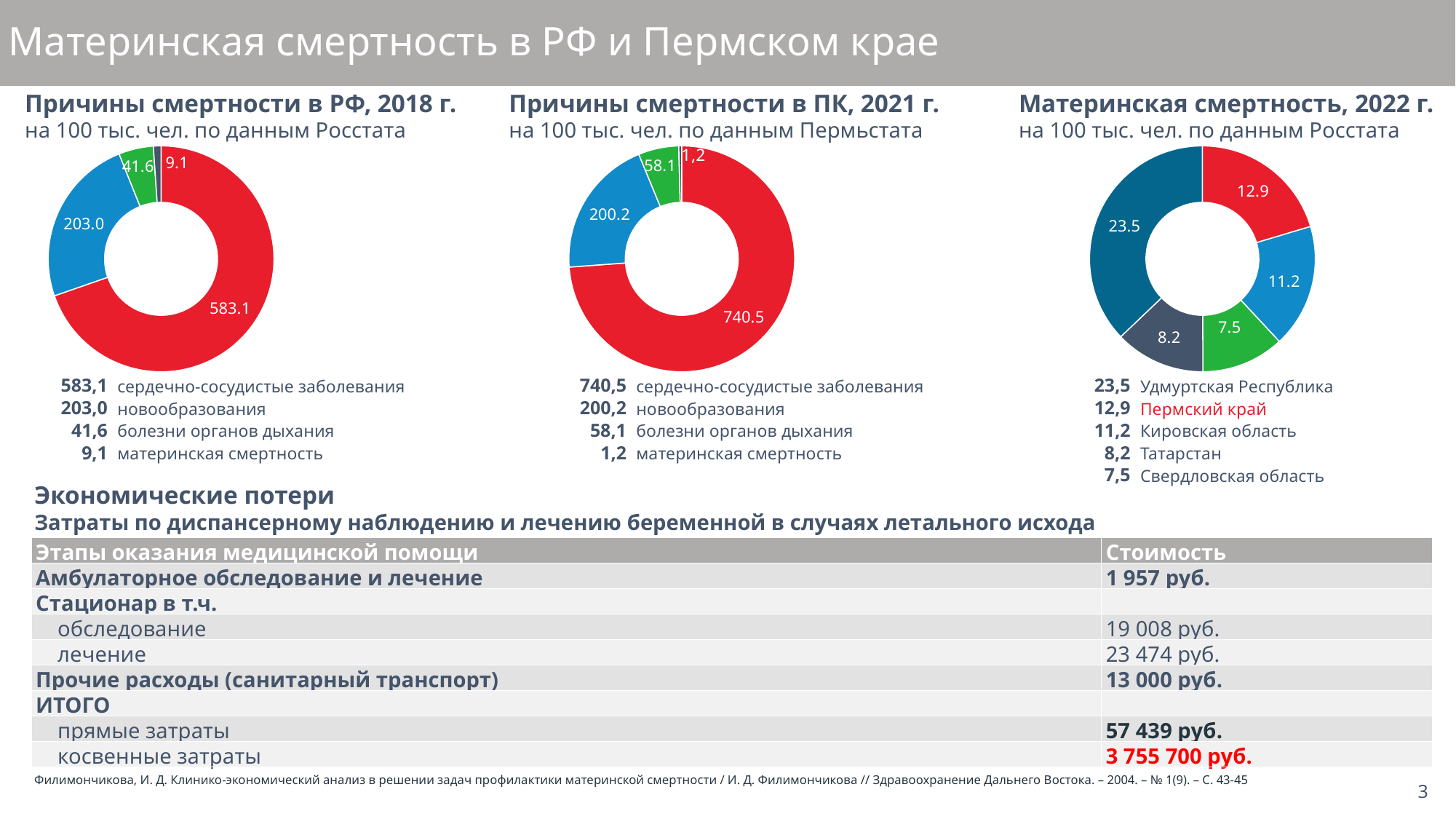
In the chart 'Причины смертности в РФ, 2018 г.', which is larger: новообразования or болезни органов дыхания? новообразования In the chart 'Материнская смертность, 2022 г.', what is the difference between Удмуртская Республика and Пермский край? 10.6 In the chart 'Причины смертности в ПК, 2021 г.', what is the difference between сердечно-сосудистые заболевания and новообразования? 540.3 What kind of chart is 'Причины смертности в РФ, 2018 г.'? Donut (pie) chart In the chart 'Причины смертности в ПК, 2021 г.', what is the value for материнская смертность? 1,2 In the chart 'Причины смертности в РФ, 2018 г.', what is the value for сердечно-сосудистые заболевания? 583.1 How many regions are shown in the chart 'Материнская смертность, 2022 г.'? 5 In the chart 'Материнская смертность, 2022 г.', which region has the lowest value? Свердловская область How many categories are shown in the chart 'Причины смертности в РФ, 2018 г.'? 4 In the chart 'Материнская смертность, 2022 г.', which region has the highest value? Удмуртская Республика In the legend of the chart 'Материнская смертность, 2022 г.', which region's name is written in red? Пермский край In the chart 'Материнская смертность, 2022 г.', what is the value for Пермский край? 12.9